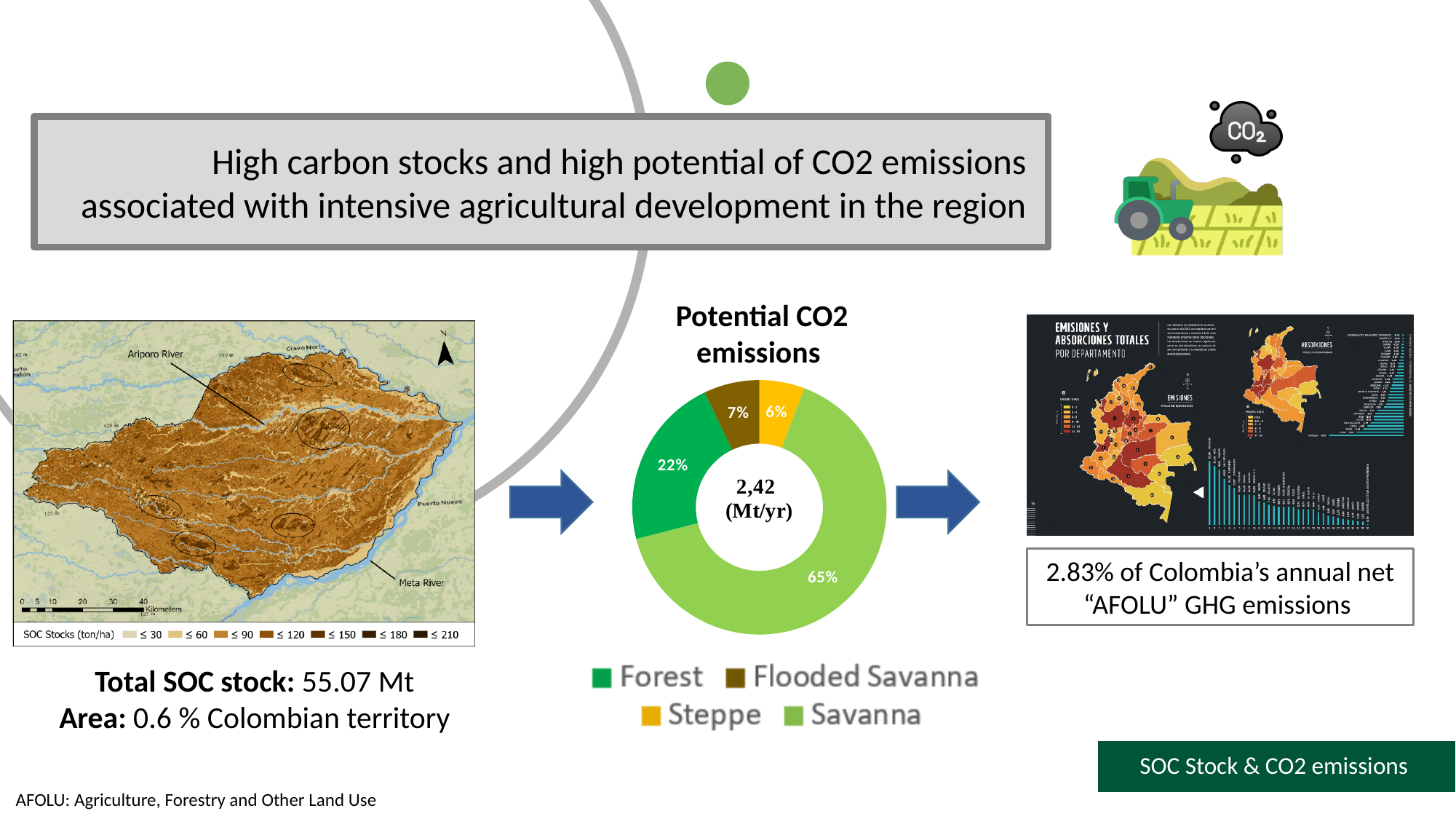
In the Potential CO2 emissions chart, which land cover type has the smallest share? Steppe In the Potential CO2 emissions chart, what is the difference in percentage points between the Savanna and Forest shares? 43 How many categories are shown in the Potential CO2 emissions chart? 4 What is the title of the chart in the middle of the slide? Potential CO2 emissions In the Potential CO2 emissions chart, what share of emissions comes from Forest? 22% In the Potential CO2 emissions chart, which has a larger share, Forest or Flooded Savanna? Forest What total value is printed in the centre of the Potential CO2 emissions chart? 2,42 (Mt/yr) What kind of chart is the Potential CO2 emissions chart? doughnut chart In the Potential CO2 emissions chart, what share of emissions comes from Savanna? 65% In the Potential CO2 emissions chart, what share of emissions comes from Flooded Savanna? 7% In the Potential CO2 emissions chart, which land cover type has the largest share? Savanna In the Potential CO2 emissions chart, what share of emissions comes from Steppe? 6%